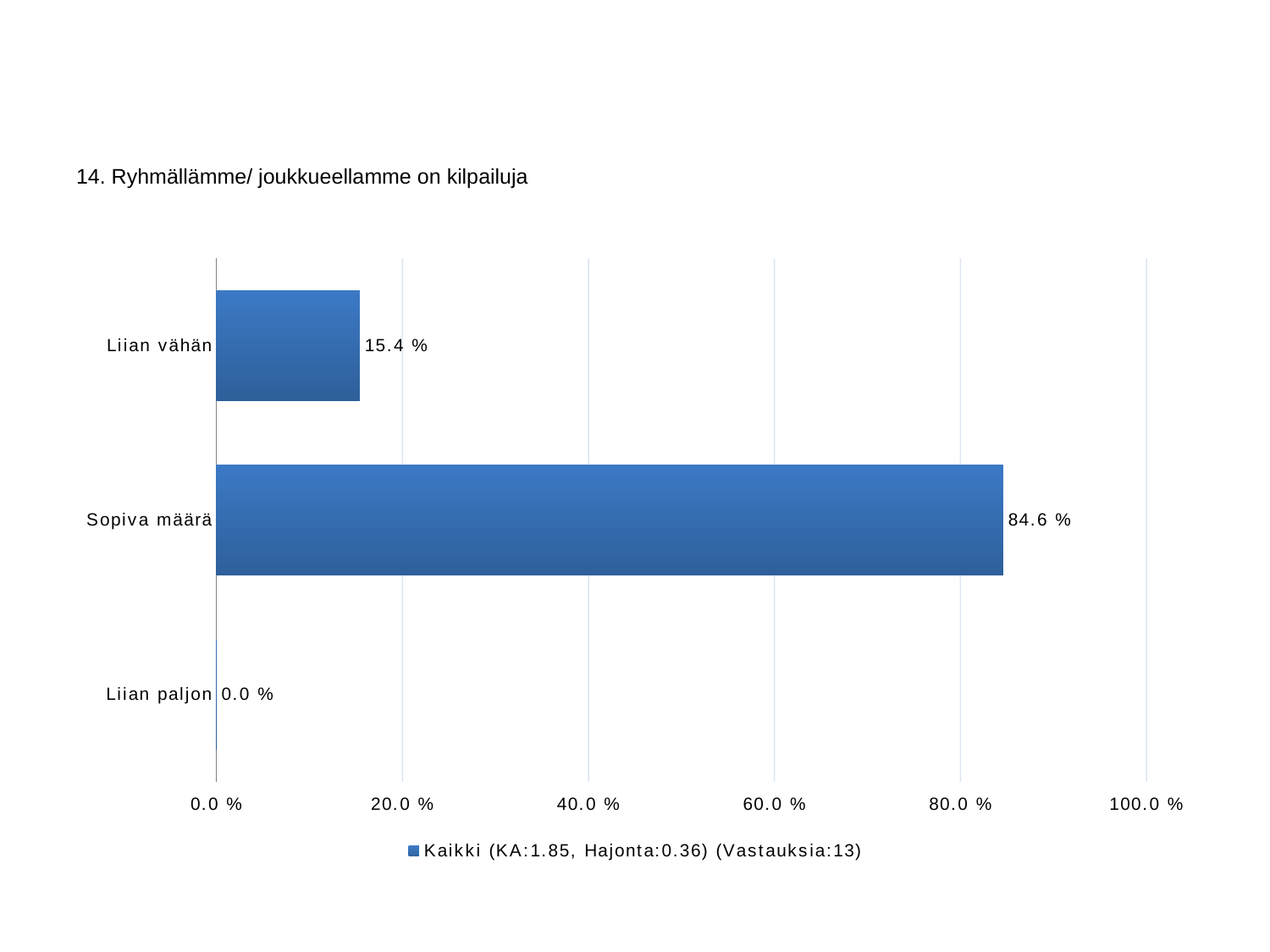
What is the value for Liian vähän? 15.4 % Which category has the highest value? Sopiva määrä What is the title of the chart? 14. Ryhmällämme/ joukkueellamme on kilpailuja What is the difference between the values for Sopiva määrä and Liian vähän? 69.2 % What is the value for Liian paljon? 0.0 % Which is larger, the value for Liian vähän or the value for Sopiva määrä? Sopiva määrä What kind of chart is shown on the slide? bar chart How many series does the legend list? 1 What is the value for Sopiva määrä? 84.6 % How many categories are shown on the chart? 3 Which category has the lowest value? Liian paljon Is the value for Sopiva määrä greater or less than 80.0 %? greater